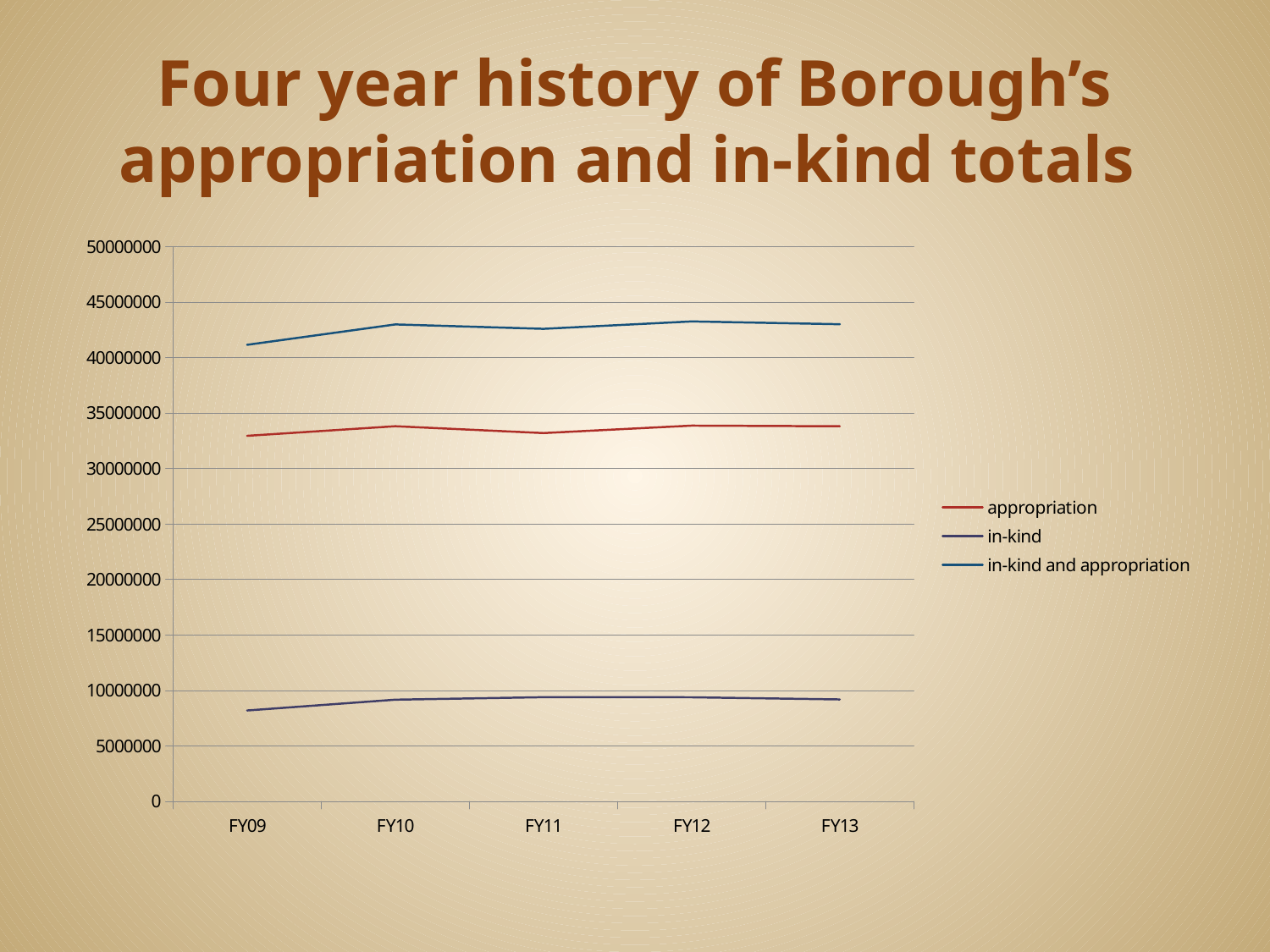
Does the in-kind and appropriation line rise or fall from FY09 to FY10? rise Which series has the lowest values across all years? in-kind In which fiscal year is the in-kind value lowest? FY09 Which series has the highest values across all years? in-kind and appropriation How many series does the legend list? 3 What kind of chart is shown on the slide? line chart In which fiscal year is the in-kind and appropriation value lowest? FY09 Is the in-kind value for FY09 greater or less than 10000000? less What is the title of the slide containing the chart? Four year history of Borough's appropriation and in-kind totals Is the appropriation value for FY10 greater or less than 35000000? less How many fiscal years are plotted along the x axis? 5 Is the in-kind and appropriation value for FY09 greater or less than 40000000? greater